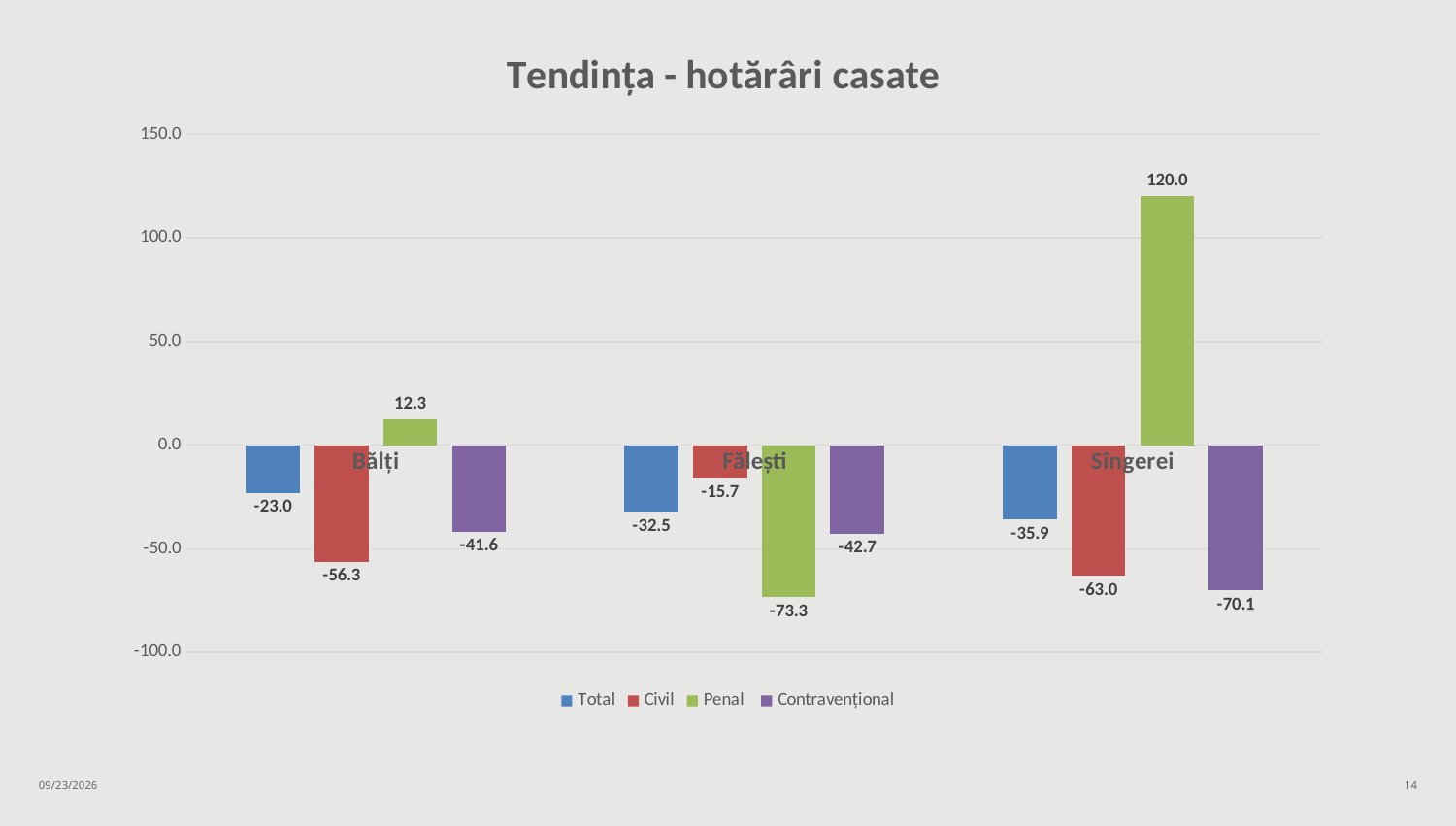
What is the Total value for Sîngerei? -35.9 What is the difference between the Penal values for Sîngerei and Bălți? 107.7 Which category has the highest Penal value? Sîngerei How many series does the legend list? 4 How many categories are shown on the x axis? 3 What is the title of the chart? Tendința - hotărâri casate What kind of chart is shown on the slide? bar chart What is the Civil value for Bălți? -56.3 What is the Contravențional value for Fălești? -42.7 What is the Penal value for Sîngerei? 120.0 Which category has the lowest Contravențional value? Sîngerei Which is larger, the Civil value for Fălești or the Civil value for Bălți? Fălești